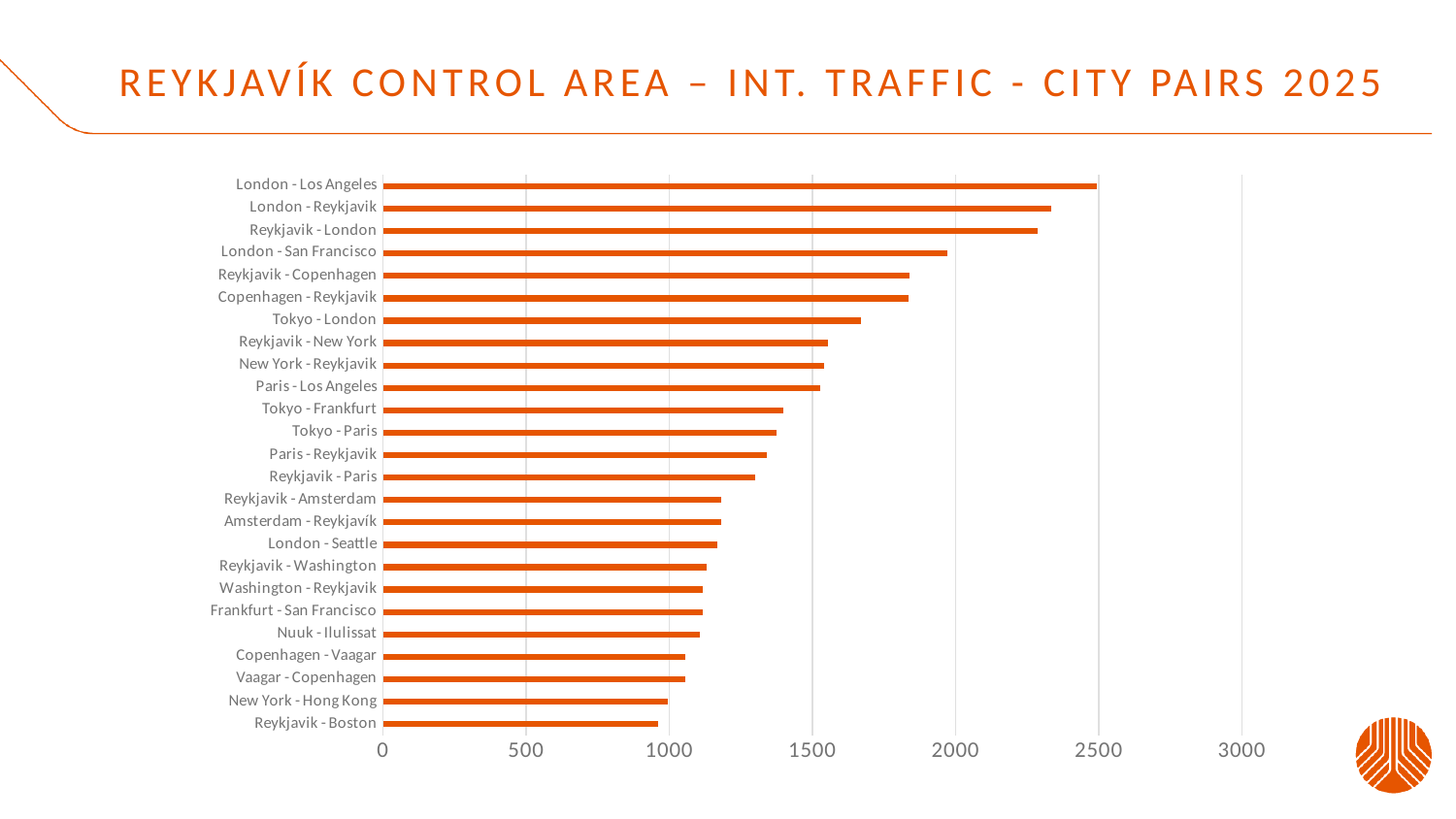
Is the value for Reykjavik - Boston greater or less than 1000? less Do the bar values increase or decrease going from the top of the chart to the bottom? decrease Which has the larger value, London - Los Angeles or London - San Francisco? London - Los Angeles Which city pair has the lowest value? Reykjavik - Boston What is the title of the chart? REYKJAVÍK CONTROL AREA – INT. TRAFFIC - CITY PAIRS 2025 Is the value for Nuuk - Ilulissat greater or less than 1000? greater Is the value for Tokyo - Frankfurt greater or less than 1500? less Which city pair has the highest value? London - Los Angeles What kind of chart is shown on the slide? Bar chart How many city pairs are plotted in the chart? 25